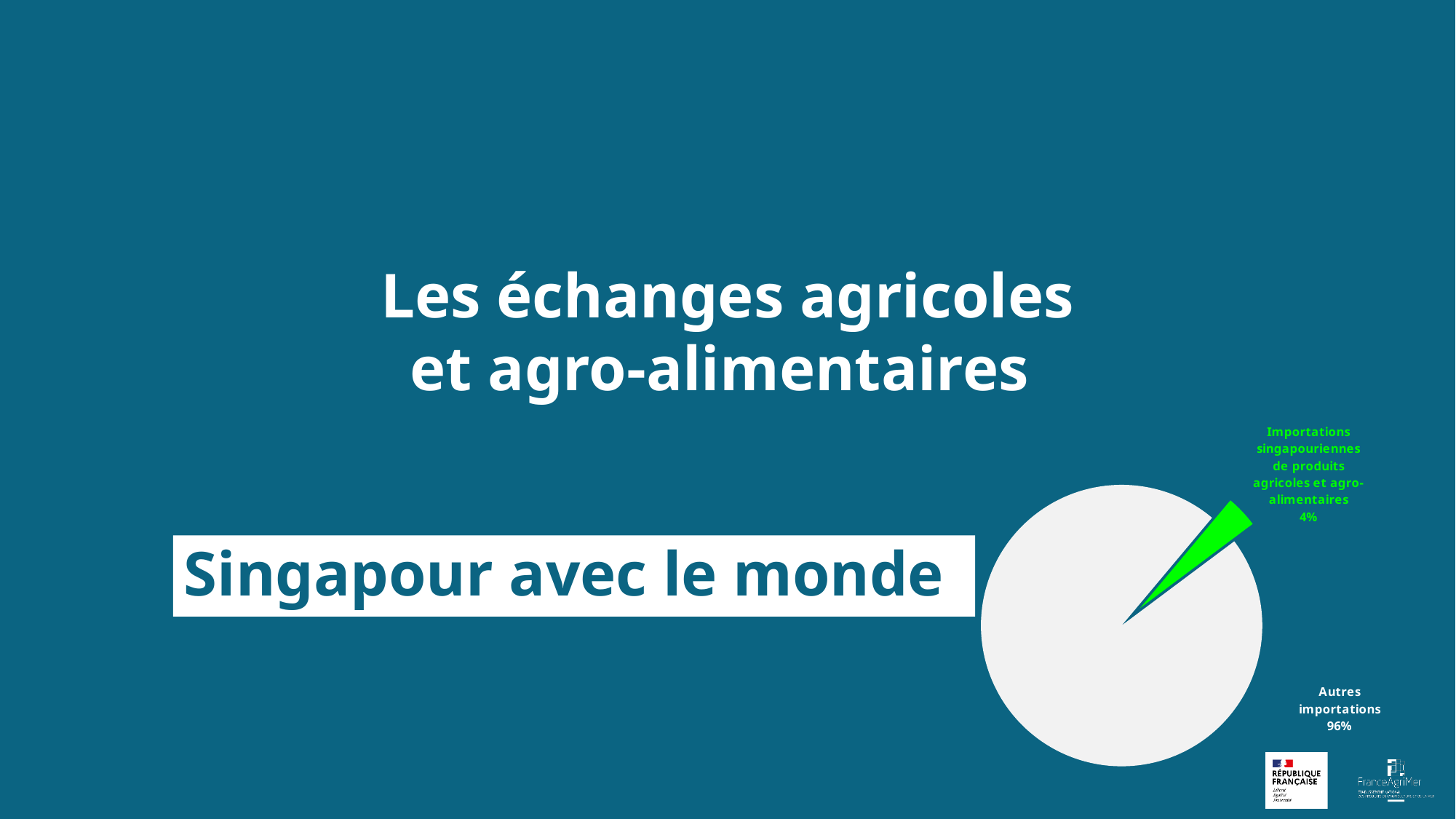
What is the total of the two slice percentages shown on the pie chart? 100% What colour is the slice for 'Importations singapouriennes de produits agricoles et agro-alimentaires'? green What share of the pie is labelled 'Autres importations'? 96% What kind of chart is shown on the slide? pie chart Which slice of the pie is the largest? Autres importations What share of the pie is labelled 'Importations singapouriennes de produits agricoles et agro-alimentaires'? 4% Which slice of the pie is the smallest? Importations singapouriennes de produits agricoles et agro-alimentaires How many slices does the pie chart have? 2 What is the difference in percentage points between 'Autres importations' and 'Importations singapouriennes de produits agricoles et agro-alimentaires'? 92 Which is larger: 'Autres importations' or 'Importations singapouriennes de produits agricoles et agro-alimentaires'? Autres importations